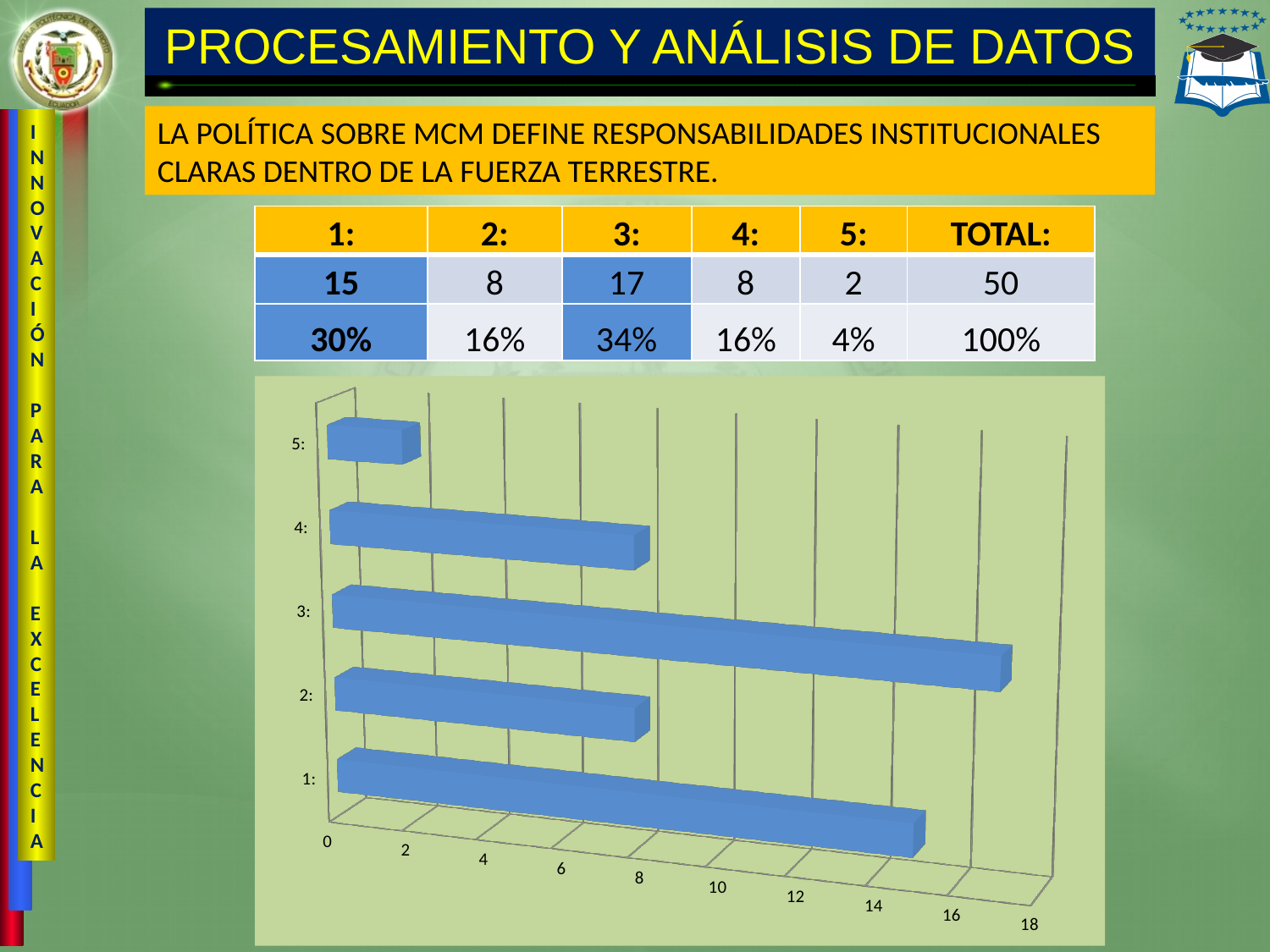
Is the bar for category 3: greater or less than 16? greater Is the bar for category 5: greater or less than 4? less Which category has the longest bar in the chart? 3: What is the highest tick value shown on the value axis of the chart? 18 Using the values in the table, what is the difference between category 3: and category 1:? 2 Which category has the shortest bar in the chart? 5: According to the table, what is the value for category 1:? 15 How many categories are plotted in the bar chart? 5 According to the table, what is the value for category 3:? 17 What kind of chart is shown on the slide? bar chart Is the bar for category 1: greater or less than 14? greater Which bar is longer, category 1: or category 4:? 1: